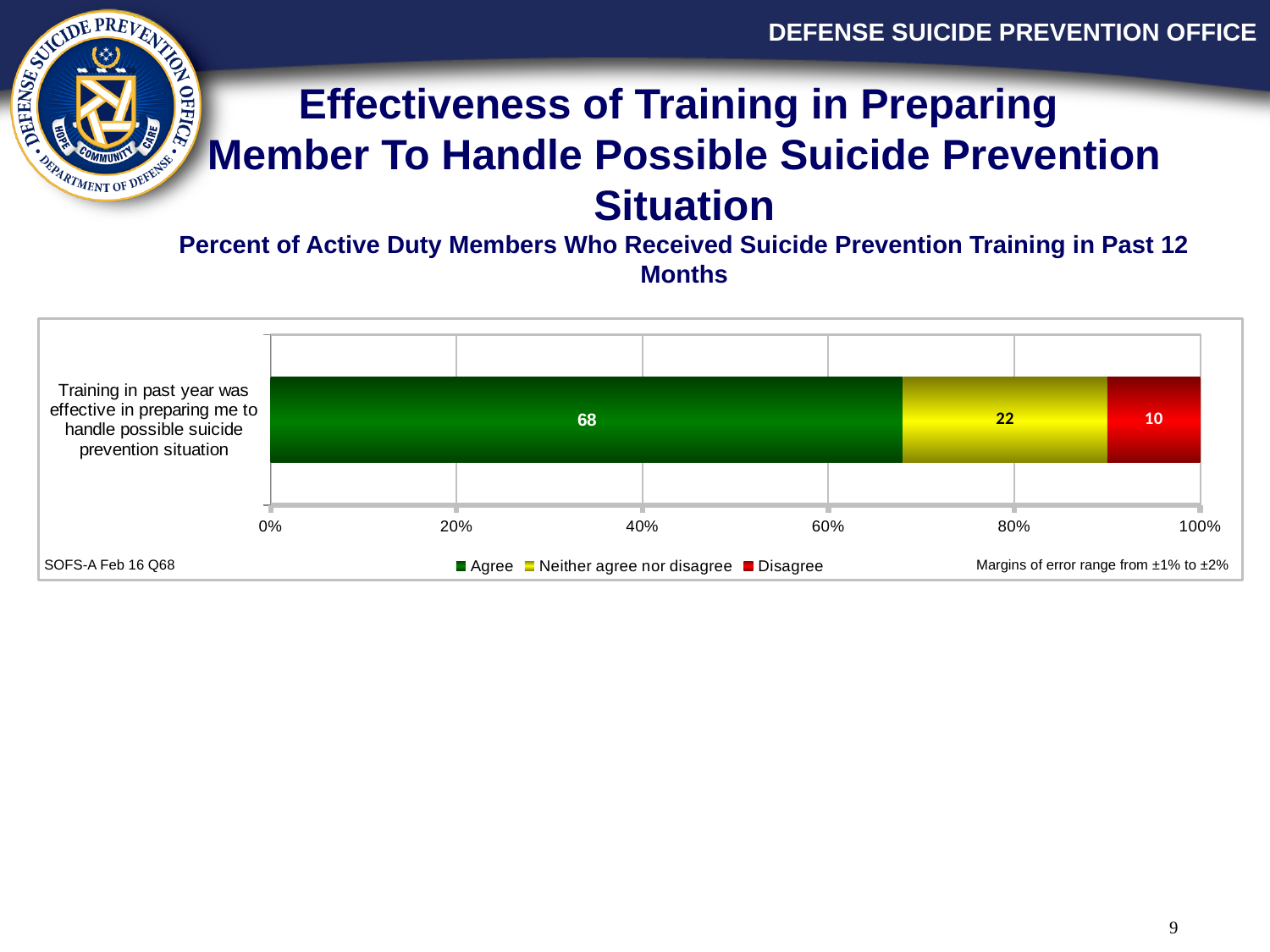
What is the value for 'Neither agree nor disagree' in the chart? 22 What is the difference between the 'Neither agree nor disagree' and 'Disagree' values? 12 What is the difference between the 'Agree' and 'Disagree' values? 58 What is the total of the stacked bar? 100 What colour represents 'Disagree' in the chart? Red How many series does the legend list? 3 Which is larger, the 'Agree' value or the 'Neither agree nor disagree' value? Agree What kind of chart is shown on the slide? Stacked bar chart Which response category has the highest value in the chart? Agree What percentage of members agree that training in the past year was effective in preparing them to handle a possible suicide prevention situation? 68 Which response category has the lowest value in the chart? Disagree What is the value for 'Disagree' in the chart? 10